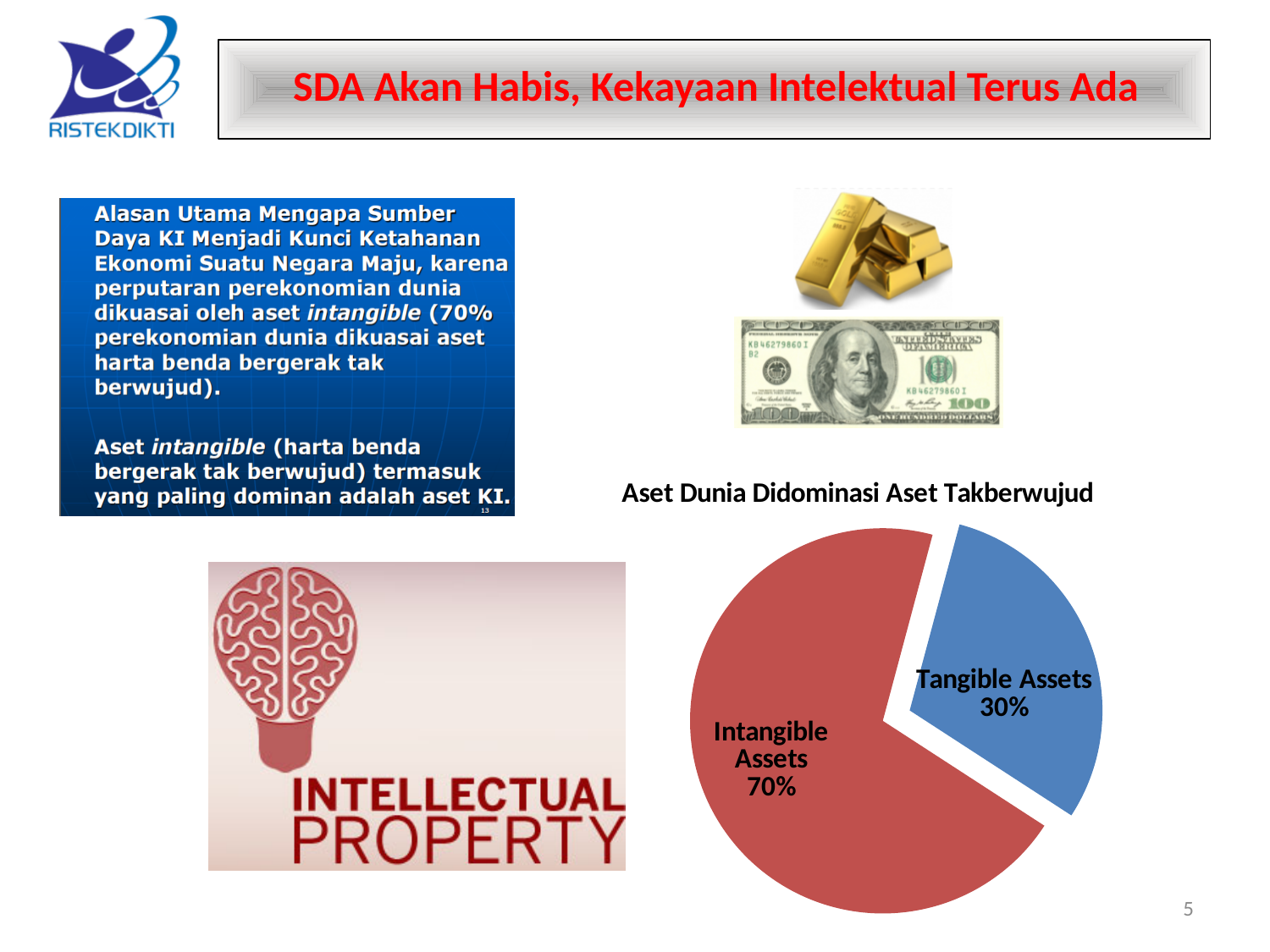
What is the title of the pie chart? Aset Dunia Didominasi Aset Takberwujud What is the difference in percentage points between Intangible Assets and Tangible Assets? 40% How many slices does the pie chart have? 2 What kind of chart is shown on the slide? pie chart What share of the pie is Tangible Assets? 30% Which slice of the pie chart is the smallest? Tangible Assets What share of the pie is Intangible Assets? 70% What is the total of the two slices shown in the pie chart? 100% What colour is the Tangible Assets slice? blue Which slice of the pie chart is the largest? Intangible Assets Which is larger, Tangible Assets or Intangible Assets? Intangible Assets